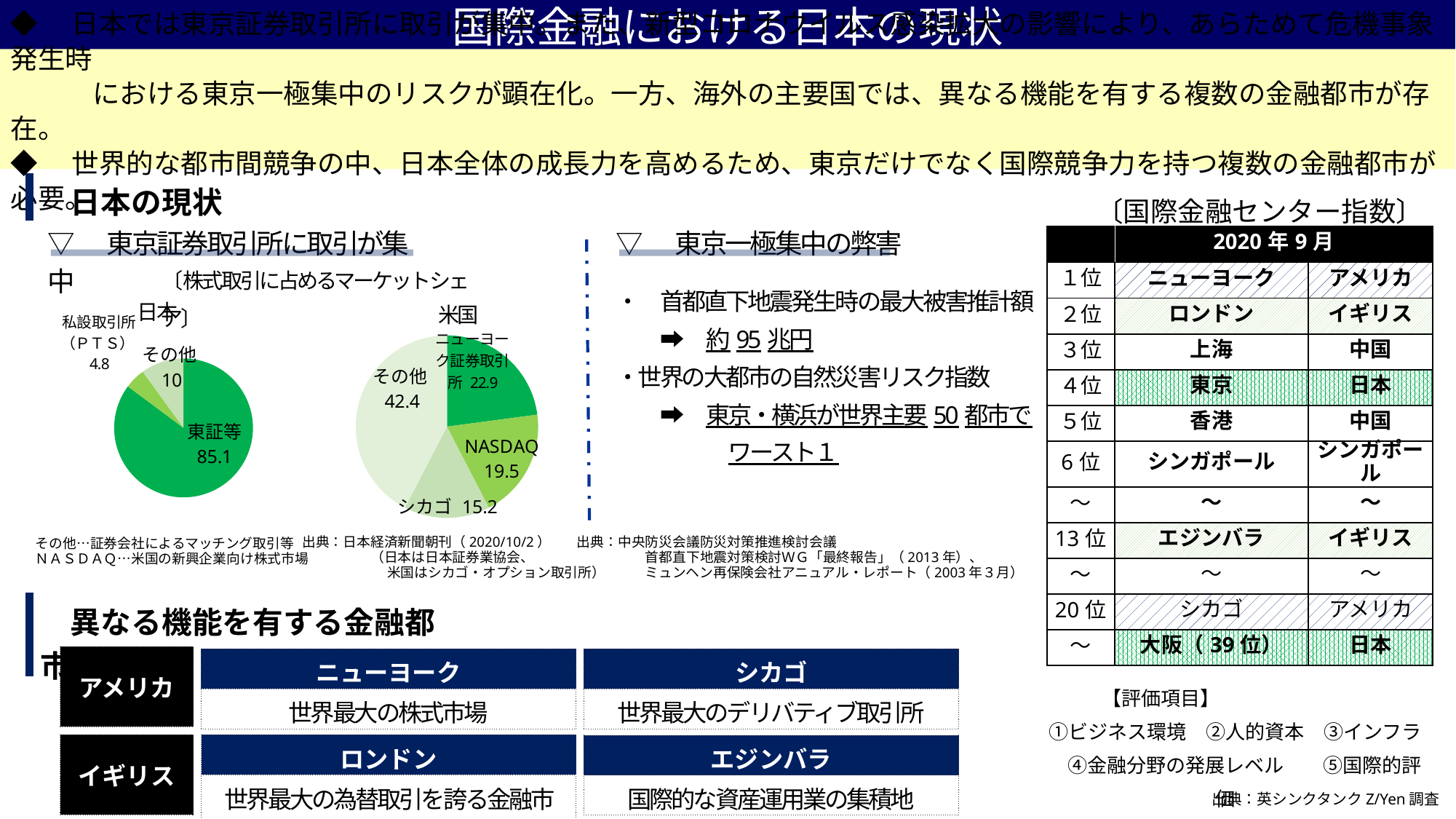
In the 米国 pie chart, what is the difference between the values for ニューヨーク証券取引所 and NASDAQ? 3.4 In the 米国 pie chart, what is the value for ニューヨーク証券取引所? 22.9 What kind of chart is used to show the 日本 market share? pie chart In the 米国 pie chart, which category has the smallest value? シカゴ In the 米国 pie chart, which category has the largest value? その他 In the 米国 pie chart, what is the value for NASDAQ? 19.5 How many categories does the 米国 pie chart show? 4 In the 日本 pie chart, which category has the smallest value? 私設取引所（ＰＴＳ） In the 米国 pie chart, what is the value for シカゴ? 15.2 In the 日本 pie chart, what is the value for 私設取引所（ＰＴＳ）? 4.8 In the 日本 pie chart, what is the value for 東証等? 85.1 In the 日本 pie chart, what is the value for その他? 10